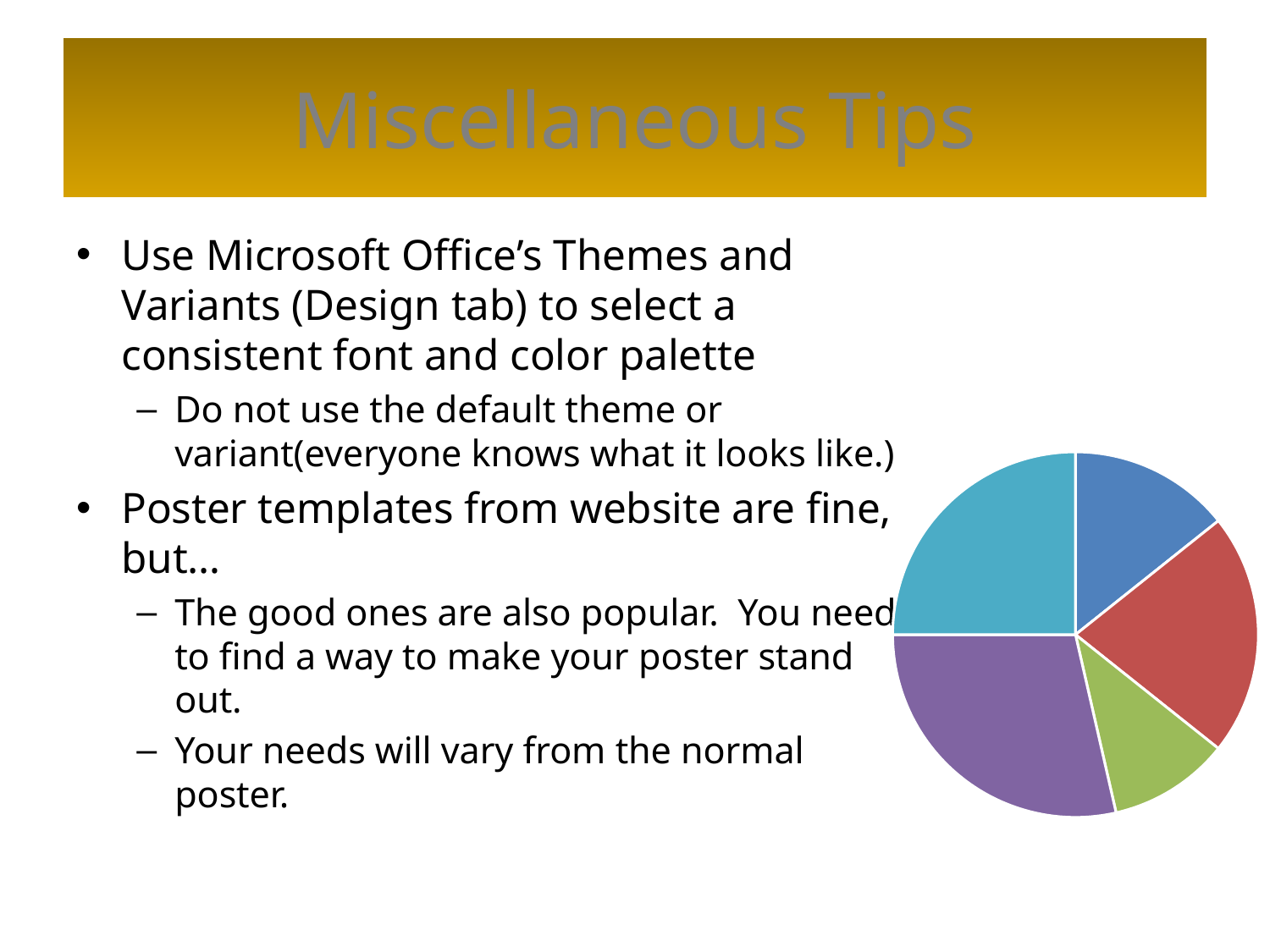
Which colour slice is the smallest in the pie chart? green How many slices does the pie chart have? 5 Does the pie chart on the slide include a legend? No What kind of chart is shown on the slide? pie chart Does the pie chart on the slide have a title? No